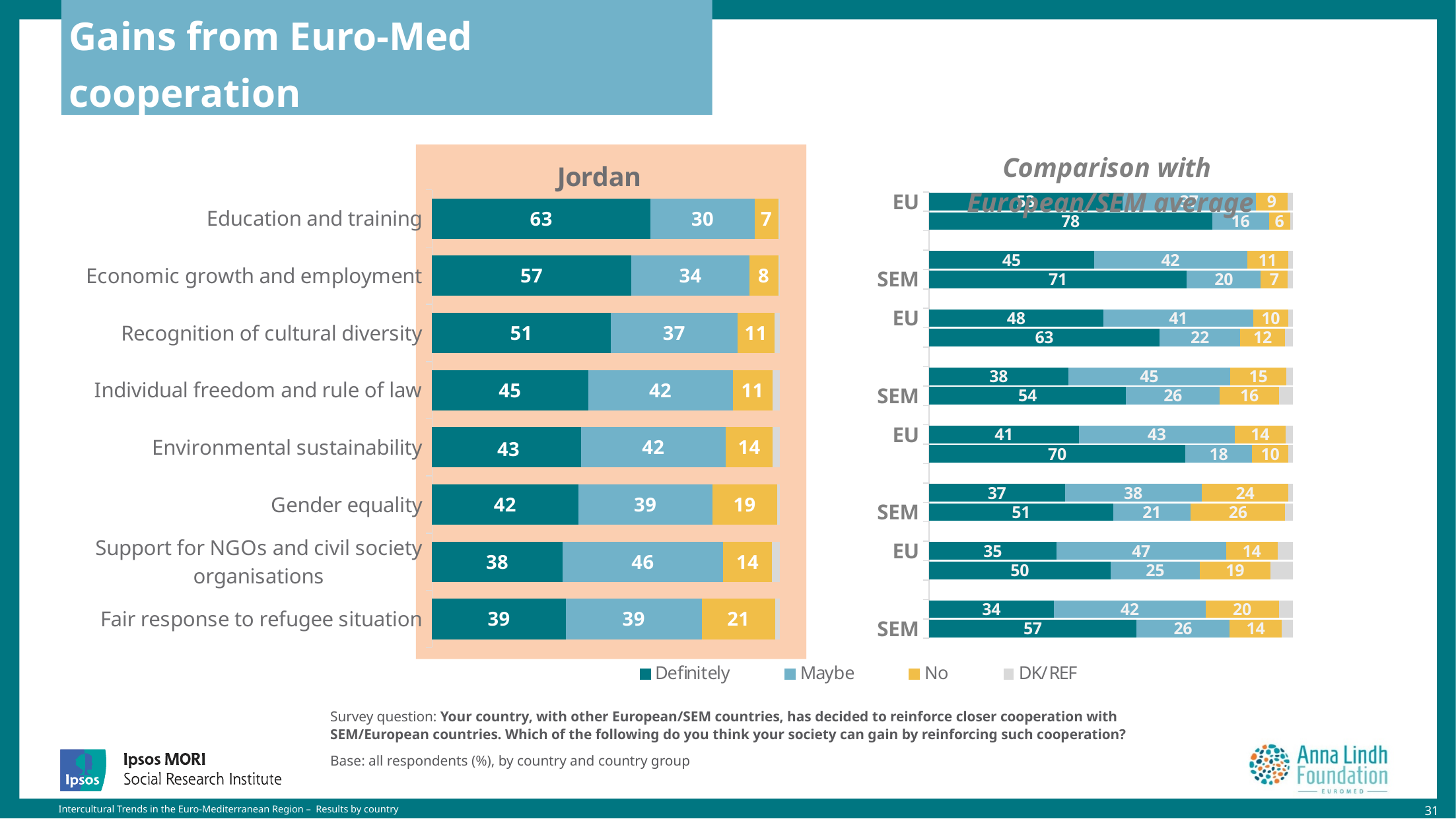
How many categories are shown in the Jordan chart? 8 What type of chart is the Jordan chart? Bar chart In the Jordan chart, what is the 'Maybe' value for Support for NGOs and civil society organisations? 46 How many series does the legend list? 4 In the Jordan chart, which has the larger 'Definitely' value: Economic growth and employment or Recognition of cultural diversity? Economic growth and employment In the Jordan chart, what is the total of the 'Definitely', 'Maybe' and 'No' values for Gender equality? 100 In the Jordan chart, what is the 'No' value for Fair response to refugee situation? 21 In the Jordan chart, what percentage answered 'Definitely' for Education and training? 63 In the Jordan chart, which category has the highest 'Definitely' value? Education and training In the Jordan chart, which category has the lowest 'Definitely' value? Support for NGOs and civil society organisations What is the title of the chart on the left side of the slide? Jordan In the Jordan chart, what is the difference between the 'Definitely' and 'Maybe' values for Education and training? 33